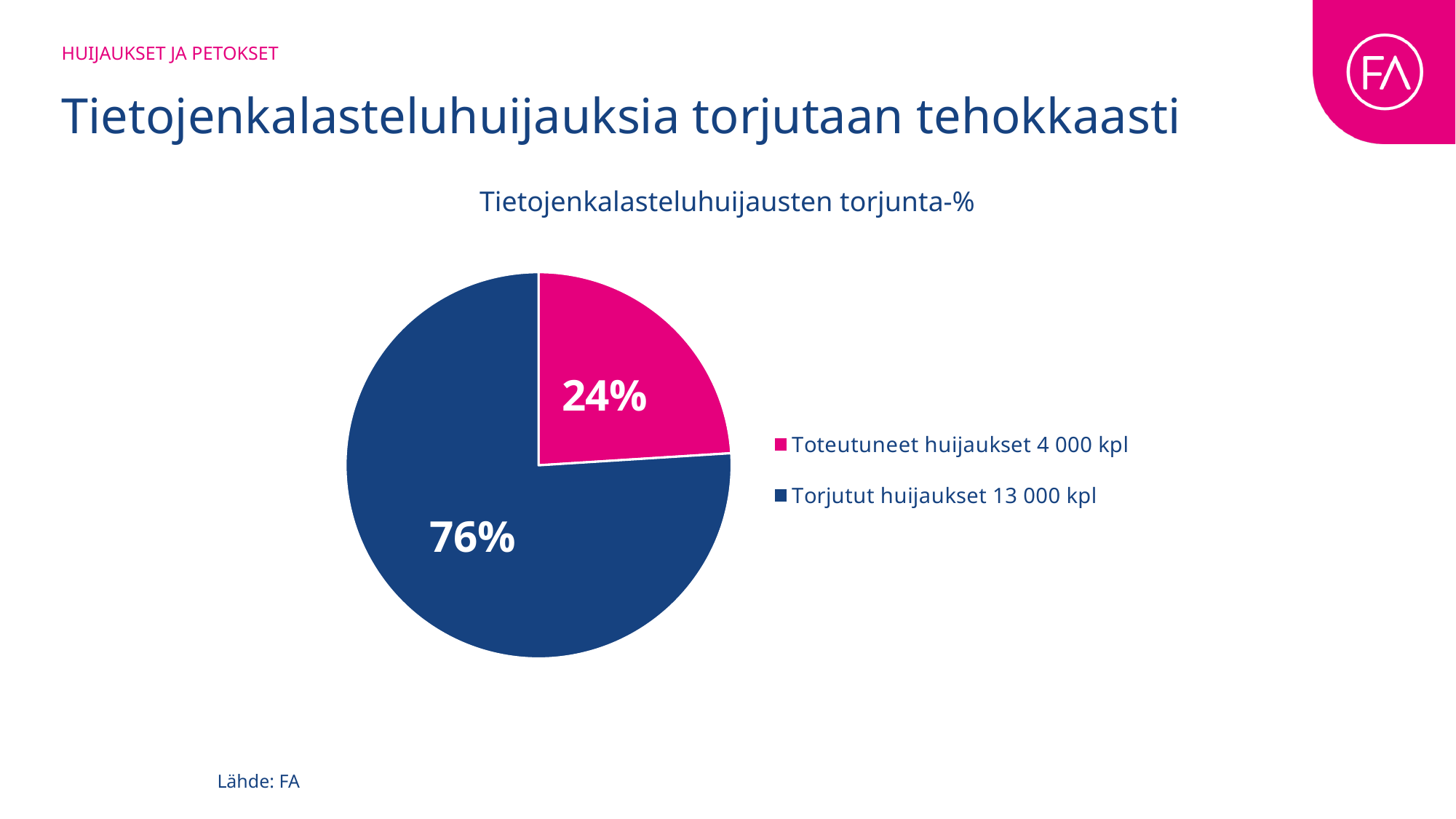
What is the title of the chart? Tietojenkalasteluhuijausten torjunta-% What percentage share does the slice 'Torjutut huijaukset 13 000 kpl' have? 76% Which is larger: the share for 'Toteutuneet huijaukset' or the share for 'Torjutut huijaukset'? Torjutut huijaukset What is the difference in percentage points between the 'Torjutut huijaukset' slice and the 'Toteutuneet huijaukset' slice? 52 How many entries does the legend list? 2 What is the source given for the chart? FA What type of chart is shown on the slide? pie chart Which slice is the largest in the pie chart? Torjutut huijaukset 13 000 kpl What percentage share does the slice 'Toteutuneet huijaukset 4 000 kpl' have? 24% Which slice is the smallest in the pie chart? Toteutuneet huijaukset 4 000 kpl How many slices does the pie chart have? 2 What colour is the slice for 'Torjutut huijaukset 13 000 kpl'? dark blue